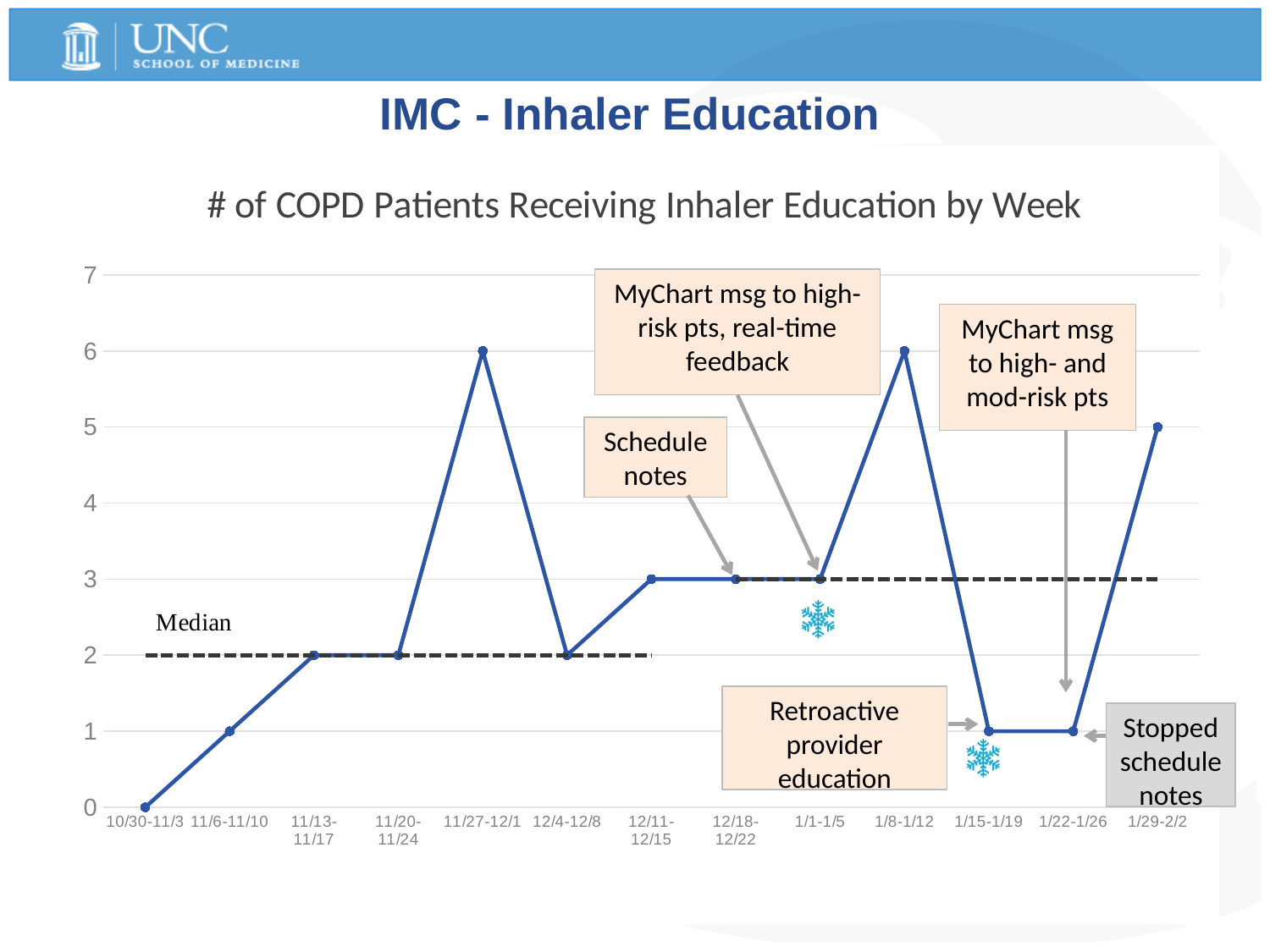
What does the dashed horizontal line on the chart represent? Median Which is larger, the value for 12/4-12/8 or the value for 1/29-2/2? 1/29-2/2 What is the value for the week 1/29-2/2? 5 What is the title of the chart? # of COPD Patients Receiving Inhaler Education by Week Is the value for 11/27-12/1 greater or less than 4? greater What is the difference between the values for 1/8-1/12 and 1/15-1/19? 5 What is the value for the week 12/11-12/15? 3 How many weeks are plotted along the x axis? 13 What is the value for the week 11/27-12/1? 6 What is the value for the week 1/15-1/19? 1 What type of chart is shown on the slide? line chart Which week has the lowest value? 10/30-11/3